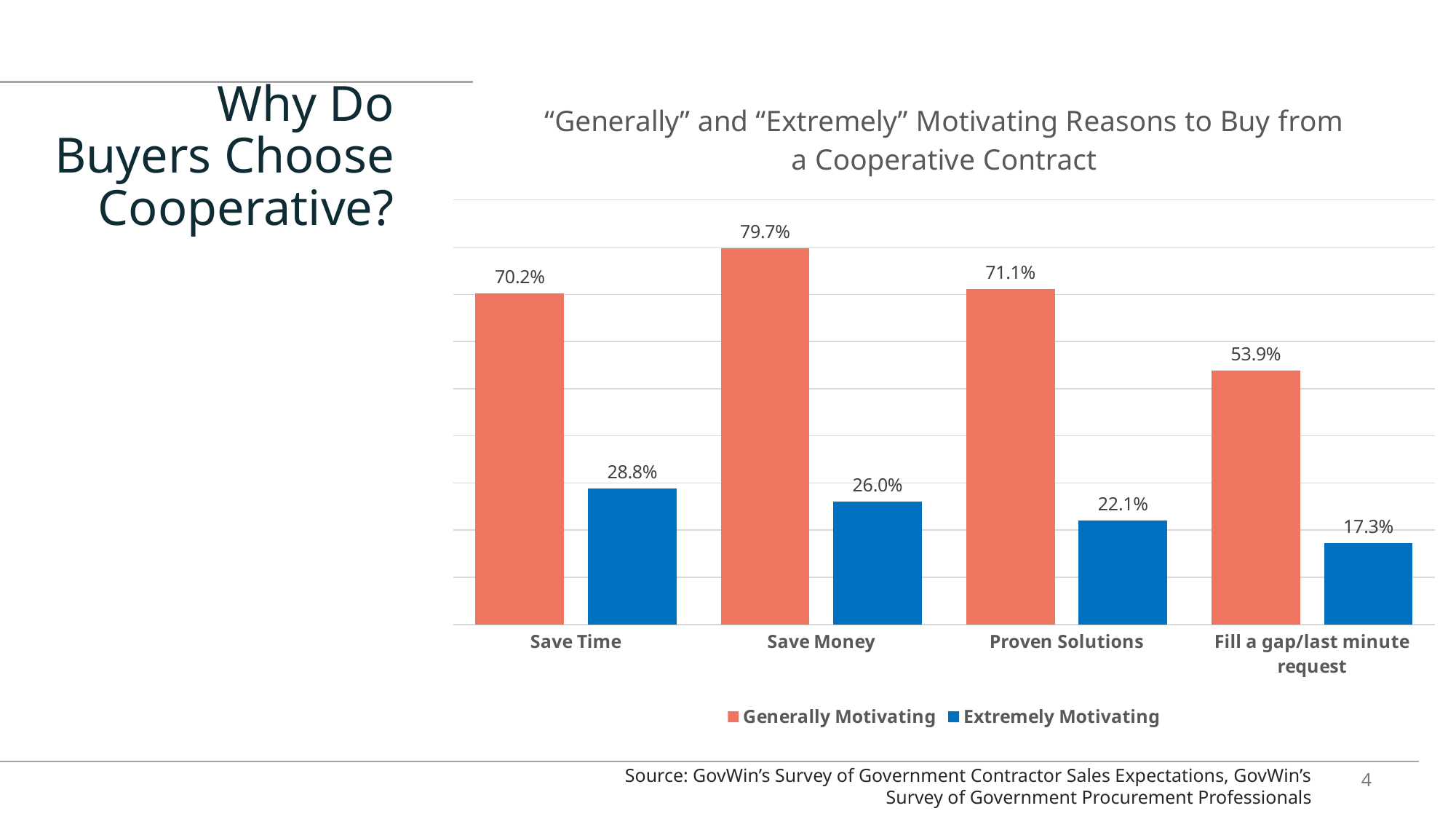
What is the Generally Motivating value for Save Money? 79.7% What kind of chart is shown on the slide? Bar chart Which category has the lowest Extremely Motivating value? Fill a gap/last minute request Which is larger: the Extremely Motivating value for Save Time or for Save Money? Save Time What is the title of the chart? “Generally” and “Extremely” Motivating Reasons to Buy from a Cooperative Contract How many categories are shown on the x axis? 4 What is the Extremely Motivating value for Save Time? 28.8% What is the Extremely Motivating value for Fill a gap/last minute request? 17.3% How many series does the legend list? 2 Which category has the highest Generally Motivating value? Save Money Which colour represents the Extremely Motivating series? Blue What is the difference between the Generally Motivating and Extremely Motivating values for Proven Solutions? 49.0%